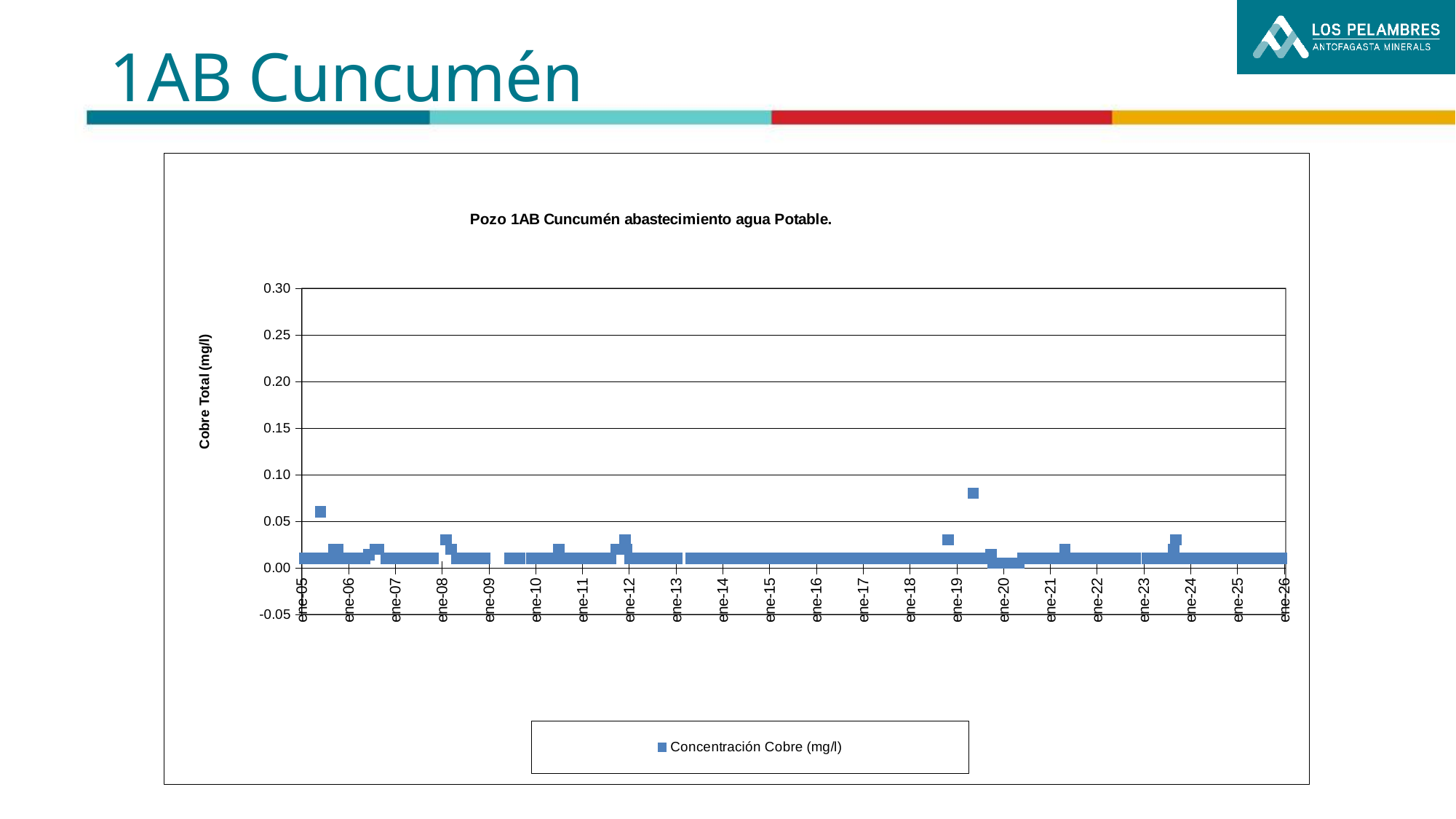
How many series does the legend list? 1 Which period contains the highest point: between ene-05 and ene-06, or between ene-19 and ene-20? between ene-19 and ene-20 Is the highest plotted value (the point between ene-19 and ene-20) greater or less than 0.05? greater Is the value plotted at ene-20 greater or less than 0.05? less What is the title of the chart? Pozo 1AB Cuncumén abastecimiento agua Potable. Are the values plotted between ene-13 and ene-18 greater or less than 0.05? less What kind of chart is shown on the slide? scatter chart What is the legend entry of the plotted series? Concentración Cobre (mg/l) Is the peak near ene-19 higher or lower than the peak near ene-05? higher How many year labels are shown on the x axis? 22